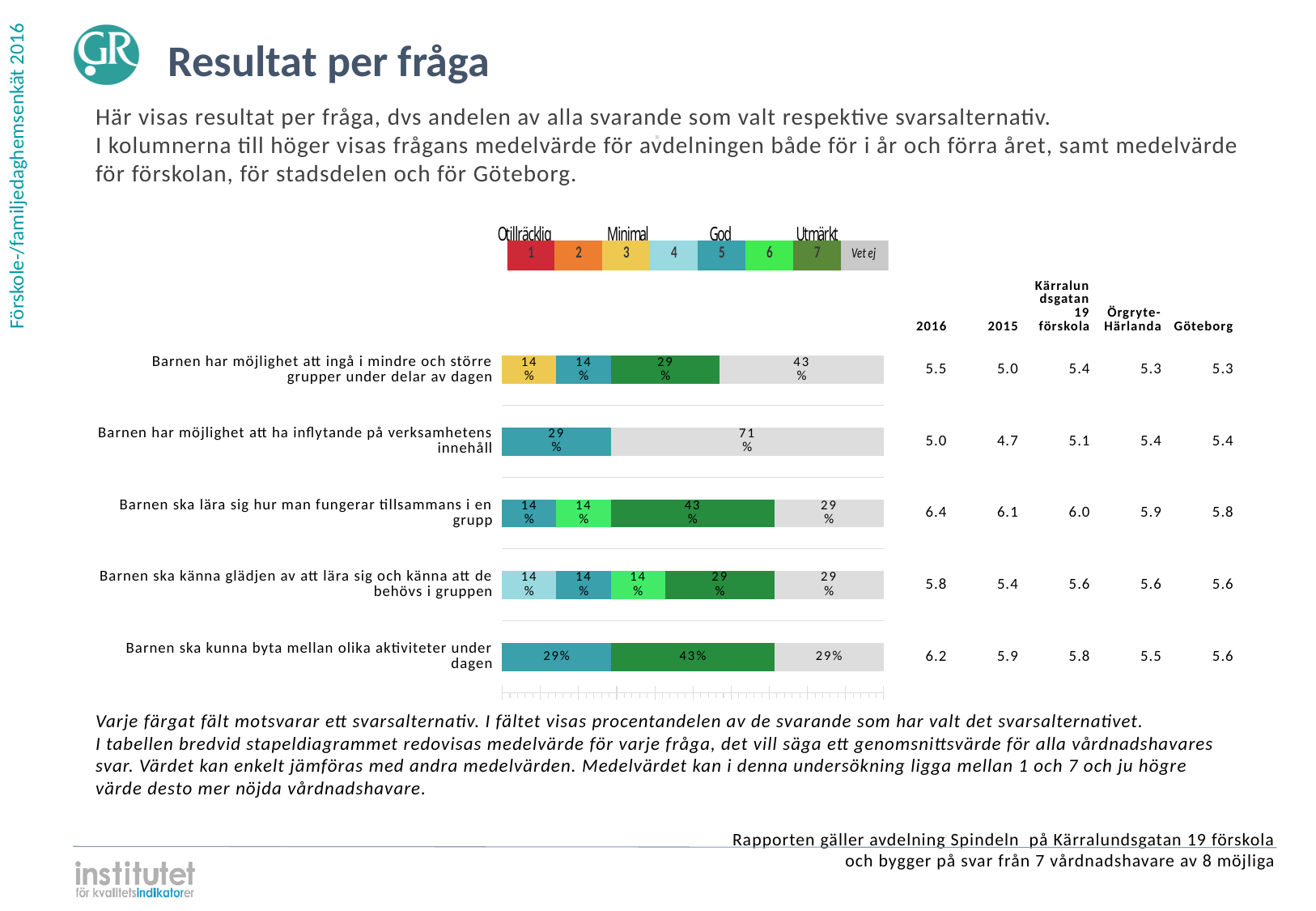
What is the title of the slide? Resultat per fråga What is the Göteborg mean value for 'Barnen ska känna glädjen av att lära sig och känna att de behövs i gruppen'? 5.6 Which is larger for 'Barnen ska kunna byta mellan olika aktiviteter under dagen': the 2016 mean or the Göteborg mean? 2016 mean What kind of chart is shown on the slide? Stacked bar chart How many answer alternatives does the colour legend above the chart list? 8 What is the 2016 mean value for 'Barnen ska lära sig hur man fungerar tillsammans i en grupp'? 6.4 What percentage of respondents chose answer 7 (Utmärkt) for 'Barnen ska kunna byta mellan olika aktiviteter under dagen'? 43% What is the difference between the 2016 and 2015 mean values for 'Barnen har möjlighet att ingå i mindre och större grupper under delar av dagen'? 0.5 What percentage of respondents answered 'Vet ej' for 'Barnen har möjlighet att ha inflytande på verksamhetens innehåll'? 71% Which question has the lowest 2015 mean value? Barnen har möjlighet att ha inflytande på verksamhetens innehåll How many questions (categories) are plotted in the bar chart? 5 Which question has the highest 2016 mean value? Barnen ska lära sig hur man fungerar tillsammans i en grupp